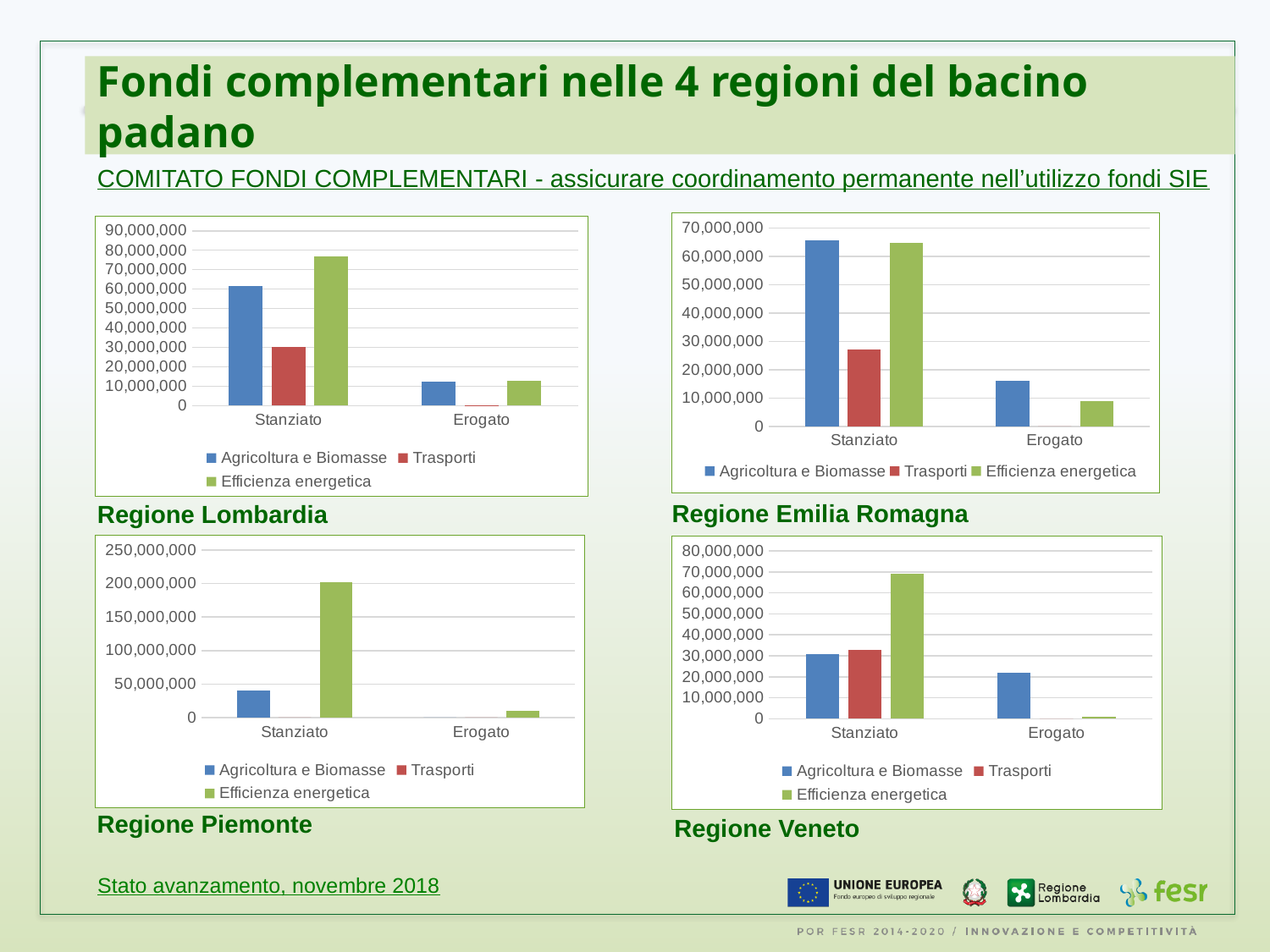
In the Regione Piemonte chart, is the Stanziato value for Efficienza energetica greater or less than 150,000,000? greater In the Regione Emilia Romagna chart, is the Stanziato value for Trasporti greater or less than 30,000,000? less In the Regione Emilia Romagna chart, which series has the larger Erogato value, Agricoltura e Biomasse or Efficienza energetica? Agricoltura e Biomasse How many series does the legend of the Regione Lombardia chart list? 3 In the Regione Veneto chart, which series has the highest Stanziato value? Efficienza energetica What kind of chart is the Regione Lombardia chart? bar chart How many categories are shown on the x axis of the Regione Veneto chart? 2 In the Regione Piemonte chart, which series has the highest Stanziato value? Efficienza energetica In the Regione Lombardia chart, which series has the highest Stanziato value? Efficienza energetica Which region's chart has a vertical axis that goes up to 250,000,000? Regione Piemonte In the Regione Lombardia chart, is the Stanziato value for Agricoltura e Biomasse greater or less than 50,000,000? greater